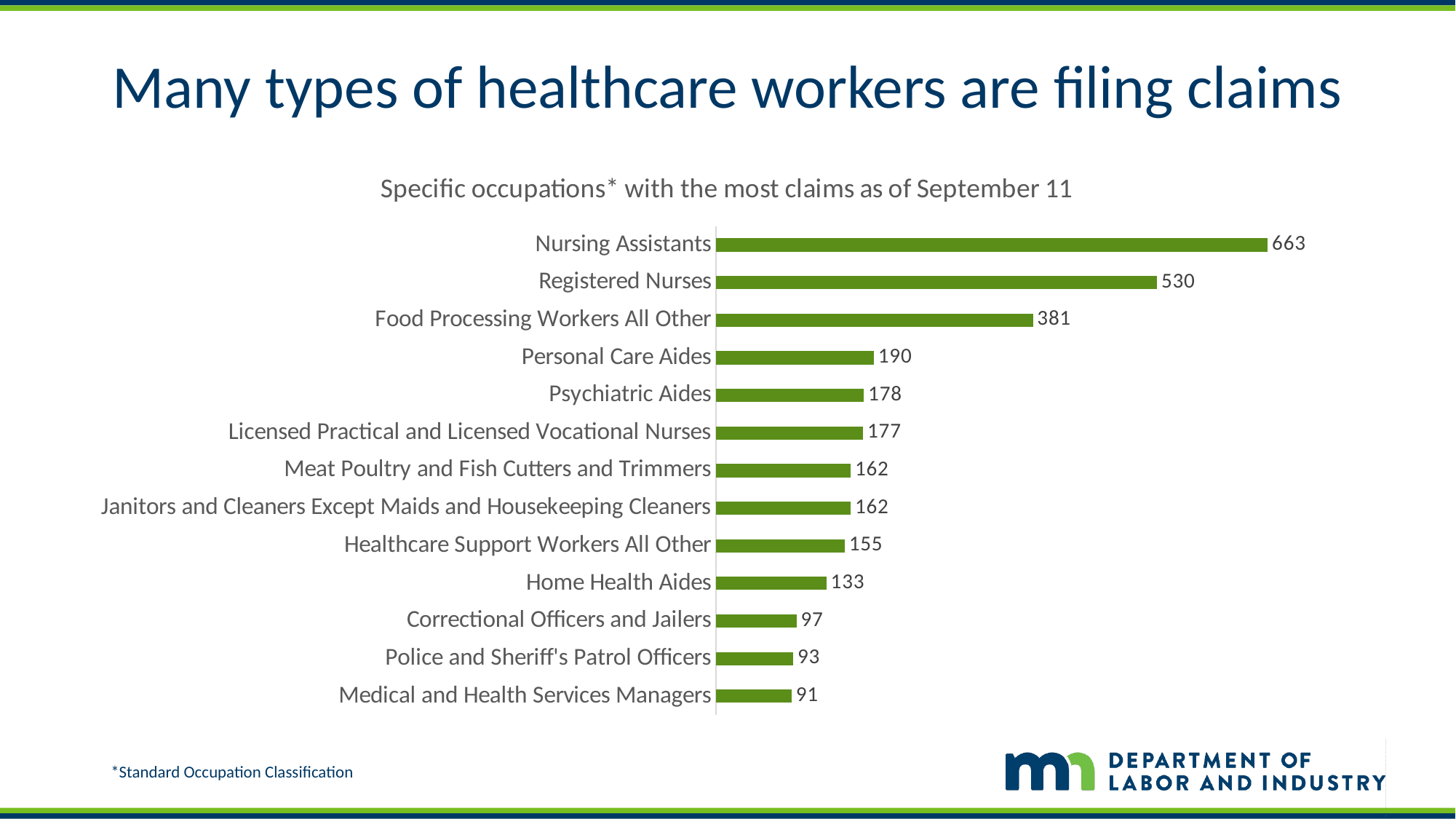
Which occupation has the fewest claims? Medical and Health Services Managers What is the value for Home Health Aides? 133 What colour are the bars in the chart? Green How many claims are shown for Nursing Assistants? 663 How many occupations are shown in the chart? 13 What kind of chart is shown on the slide? Bar chart Which has more claims, Psychiatric Aides or Home Health Aides? Psychiatric Aides What is the title of the chart? Specific occupations* with the most claims as of September 11 Which occupation has the most claims? Nursing Assistants What is the difference between the claims for Nursing Assistants and Registered Nurses? 133 What is the value for Registered Nurses? 530 What is the difference between the values for Food Processing Workers All Other and Personal Care Aides? 191